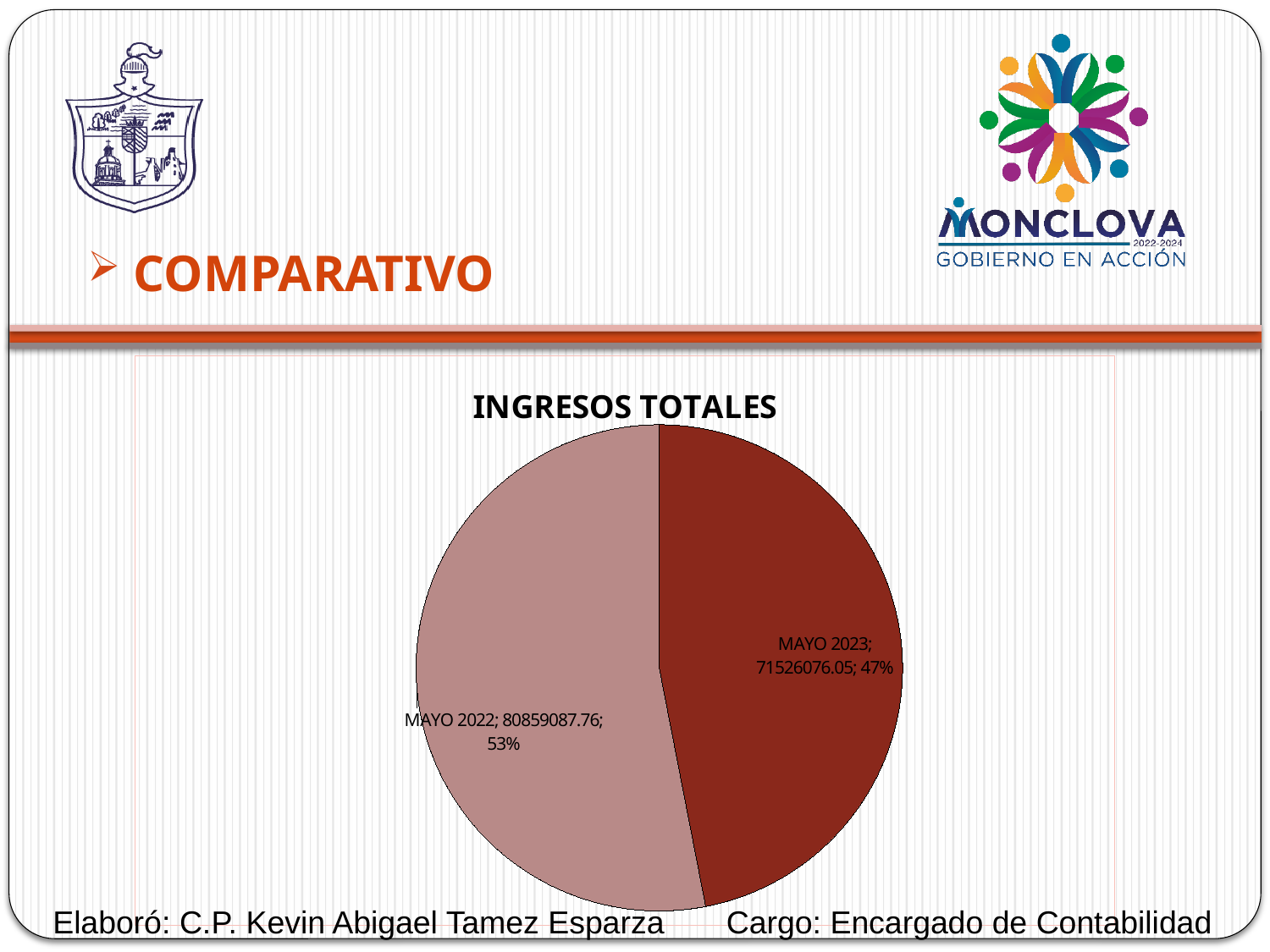
What share of the pie does MAYO 2022 represent? 53% What is the value for MAYO 2023 in the INGRESOS TOTALES chart? 71526076.05 What share of the pie does MAYO 2023 represent? 47% Which category has the smallest slice in the INGRESOS TOTALES chart? MAYO 2023 Which category has the largest slice in the INGRESOS TOTALES chart? MAYO 2022 What is the difference between the values for MAYO 2022 and MAYO 2023? 9333011.71 What is the title of the chart? INGRESOS TOTALES Which is larger, the value for MAYO 2022 or MAYO 2023? MAYO 2022 What is the total of the two values shown in the pie chart? 152385163.81 What type of chart is shown on the slide? pie chart What is the value for MAYO 2022 in the INGRESOS TOTALES chart? 80859087.76 How many slices does the pie chart have? 2